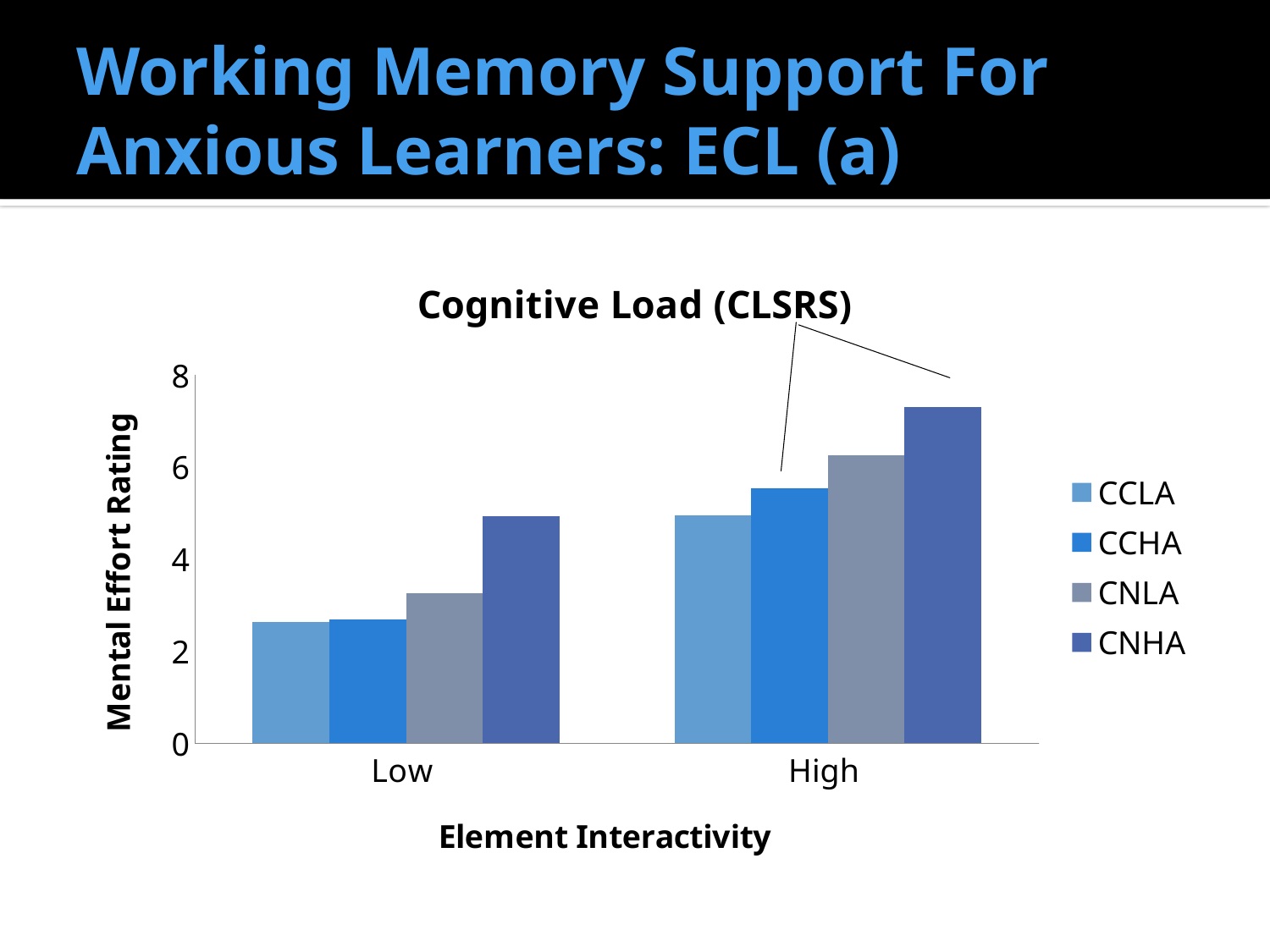
Which series has the highest bar in the Low element interactivity group? CNHA What is the title of the chart? Cognitive Load (CLSRS) Which series has the highest bar in the High element interactivity group? CNHA What is the label of the vertical axis? Mental Effort Rating Which is larger: CNLA at High element interactivity or CNHA at Low element interactivity? CNLA at High Is the value for CNHA at High element interactivity greater or less than 6? greater Is the value for CCLA at Low element interactivity greater or less than 4? less Which series has the lowest bar in the High element interactivity group? CCLA How many categories are shown on the x axis? 2 How many series does the legend list? 4 What kind of chart is shown on the slide? bar chart Does the CCHA series rise or fall from Low to High element interactivity? rise